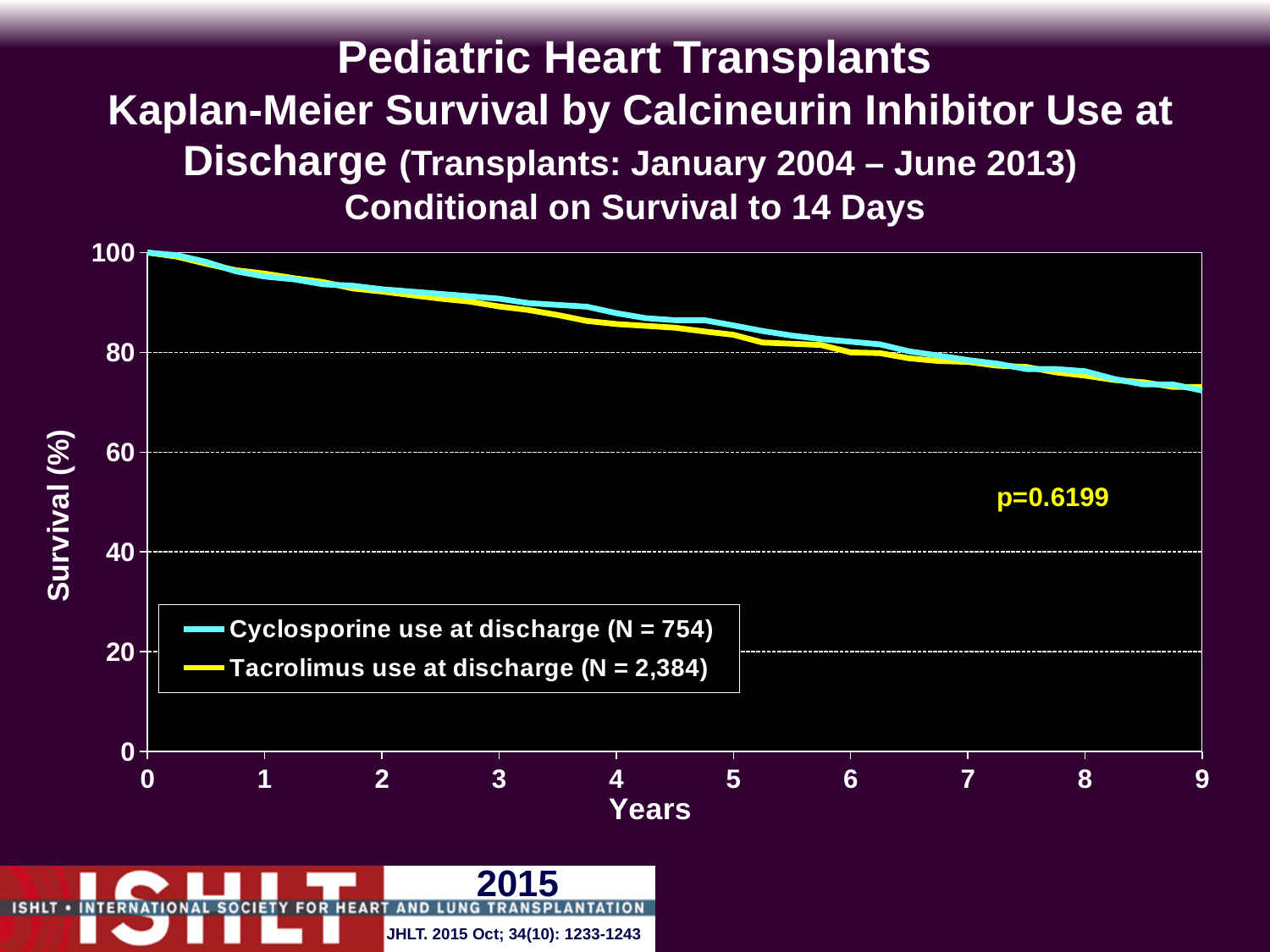
What kind of chart is shown on the slide? line chart What is the N for the Cyclosporine use at discharge group shown in the legend? 754 Is the survival value for Tacrolimus use at discharge at 9 years greater or less than 60? greater What is the highest value shown on the x axis (Years)? 9 Is the survival value for Tacrolimus use at discharge at 2 years greater or less than 80? greater How many series does the legend list? 2 What is the N for the Tacrolimus use at discharge group shown in the legend? 2,384 What p-value is printed on the chart? p=0.6199 Do the survival curves rise or fall as years increase? fall Is the survival value for Cyclosporine use at discharge at 4 years greater or less than 80? greater At 4 years, which group has the higher survival, Cyclosporine use at discharge or Tacrolimus use at discharge? Cyclosporine use at discharge